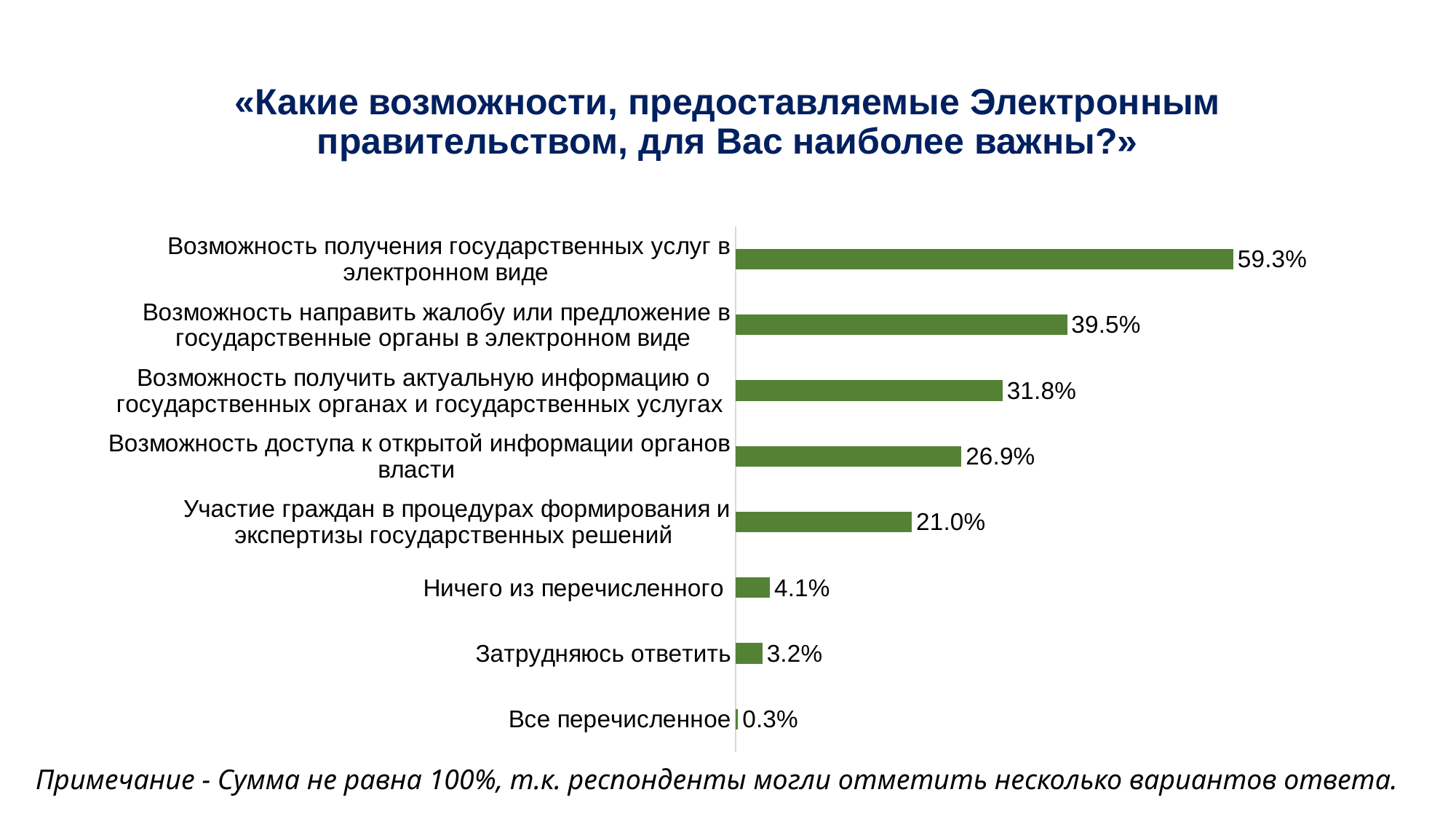
What is the value for «Участие граждан в процедурах формирования и экспертизы государственных решений»? 21.0% Which category has the highest value? Возможность получения государственных услуг в электронном виде What kind of chart is shown on the slide? Bar chart What is the difference between the values for «Возможность получения государственных услуг в электронном виде» and «Возможность направить жалобу или предложение в государственные органы в электронном виде»? 19.8% What is the value for «Затрудняюсь ответить»? 3.2% What is the value for «Возможность направить жалобу или предложение в государственные органы в электронном виде»? 39.5% What is the value for «Возможность получения государственных услуг в электронном виде»? 59.3% What is the difference between the values for «Возможность доступа к открытой информации органов власти» and «Участие граждан в процедурах формирования и экспертизы государственных решений»? 5.9% What colour are the bars in the chart? Green How many categories are shown in the chart? 8 Which category has the lowest value? Все перечисленное Which is larger: the value for «Ничего из перечисленного» or the value for «Затрудняюсь ответить»? Ничего из перечисленного